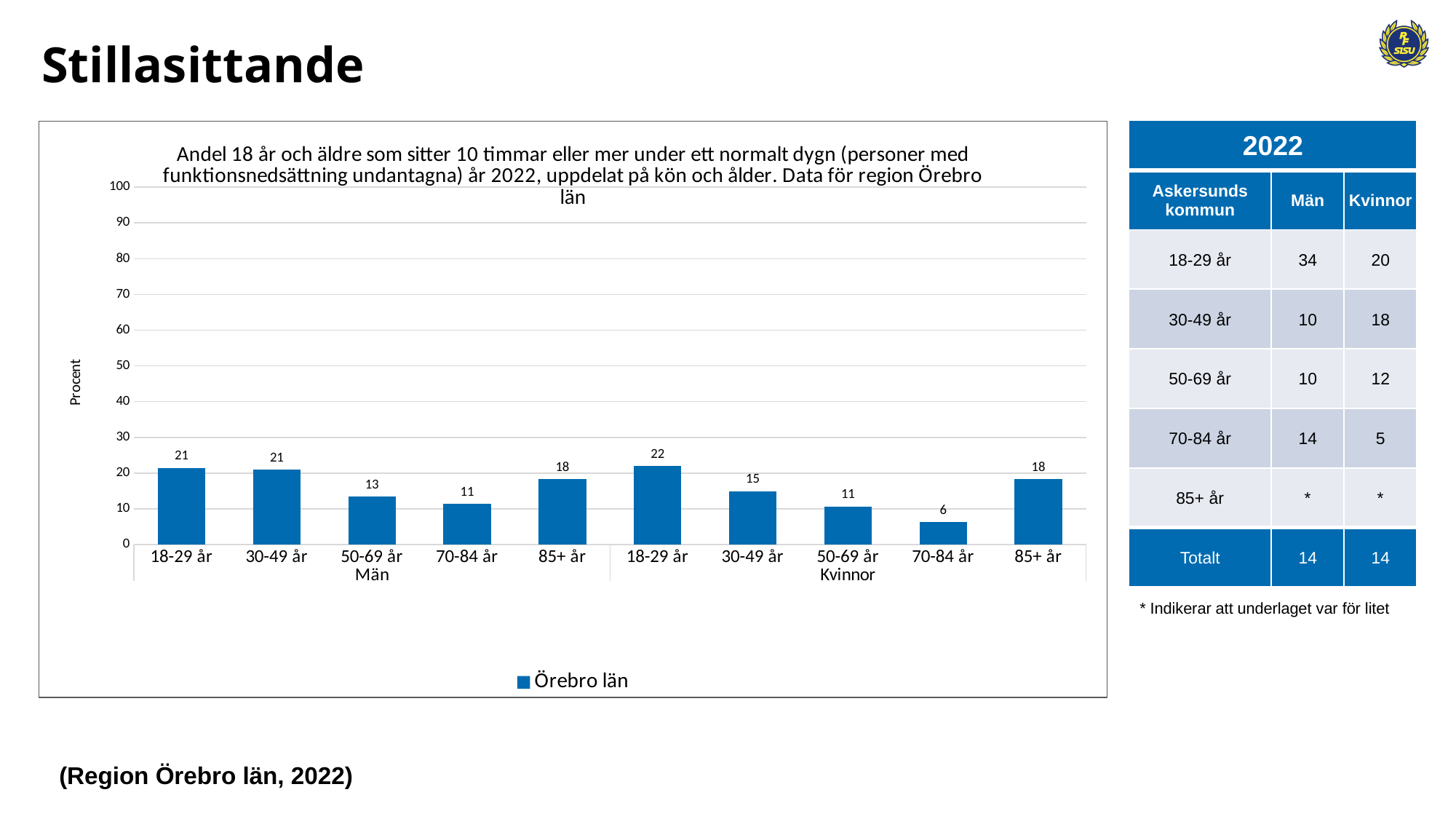
What is the difference between the values for men aged 18-29 år and men aged 70-84 år? 10 What is the value for women aged 70-84 år in the chart? 6 Which age group among women has the highest value in the chart? 18-29 år How many bars are plotted in the chart? 10 Which is larger: the value for men aged 30-49 år or women aged 30-49 år? Men aged 30-49 år Which bar has the lowest value in the whole chart? 70-84 år (Kvinnor) What is the value for men aged 50-69 år in the chart? 13 What is the label of the series shown in the chart legend? Örebro län How many series does the chart legend list? 1 What kind of chart is shown on the slide? Bar chart What is the value for women aged 30-49 år in the chart? 15 Is the value for women aged 18-29 år greater or less than 30? less